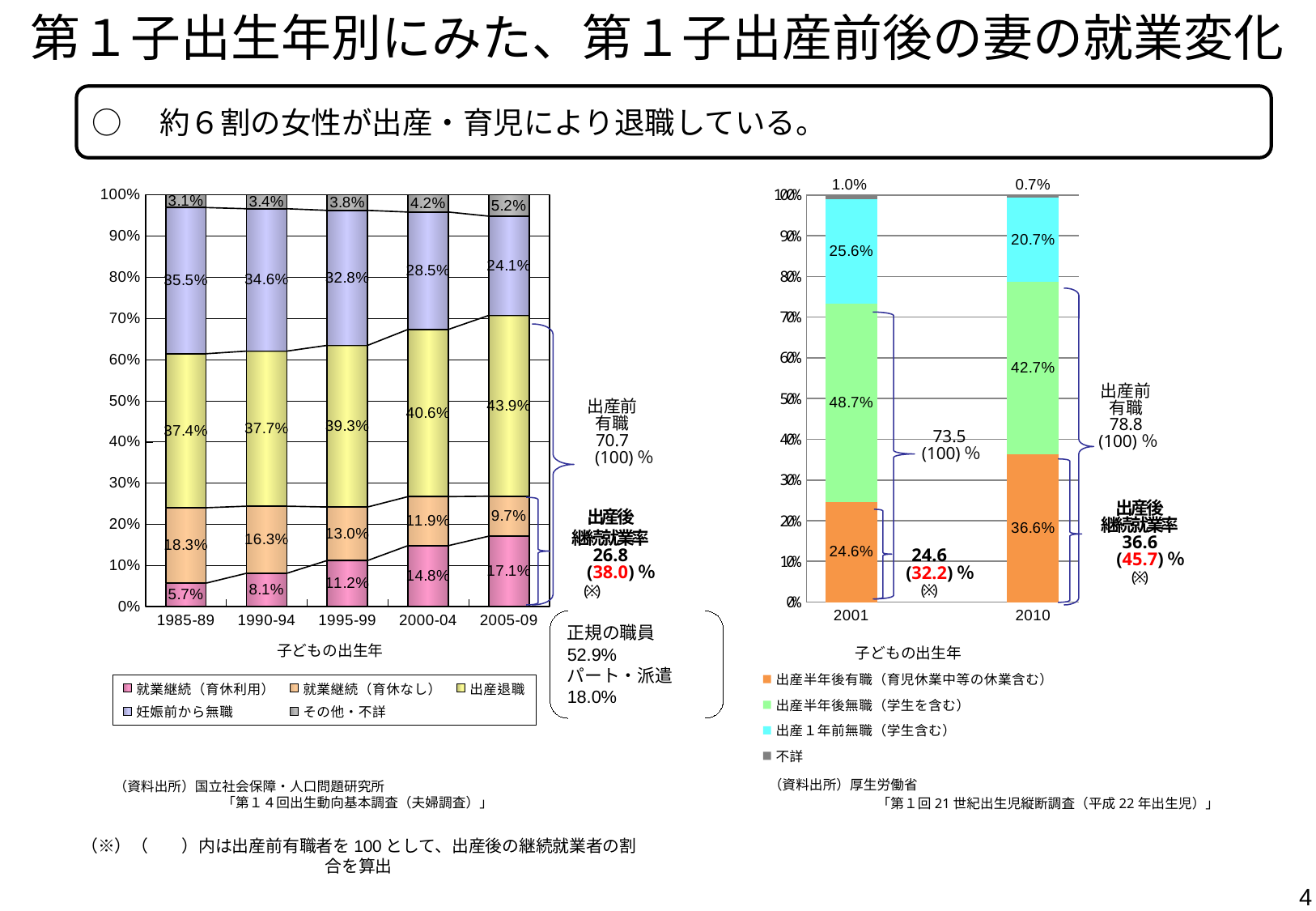
In the left chart, what is the value of 就業継続（育休利用） for 2005-09? 17.1% In the right chart, what is the difference between the 出産半年後有職 values for 2010 and 2001? 12.0% In the left chart, which birth-year group has the highest value for 就業継続（育休利用）? 2005-09 In the left chart, how many series does the legend list? 5 In the left chart, how many birth-year groups are shown on the x axis? 5 What type of chart is the right chart? Stacked bar chart In the right chart, which is larger for 2001: 出産半年後無職（学生を含む） or 出産１年前無職（学生含む）? 出産半年後無職（学生を含む） In the right chart, what is the value of 出産半年後有職（育児休業中等の休業を含む） for 2010? 36.6% In the left chart, which birth-year group has the lowest value for 妊娠前から無職? 2005-09 In the left chart, what is the difference between the 出産退職 values for 2005-09 and 1985-89? 6.5% In the left chart, what is the value of 出産退職 for 1995-99? 39.3% In the left chart, how does the value of 就業継続（育休利用） change from 1985-89 to 2005-09? It rises